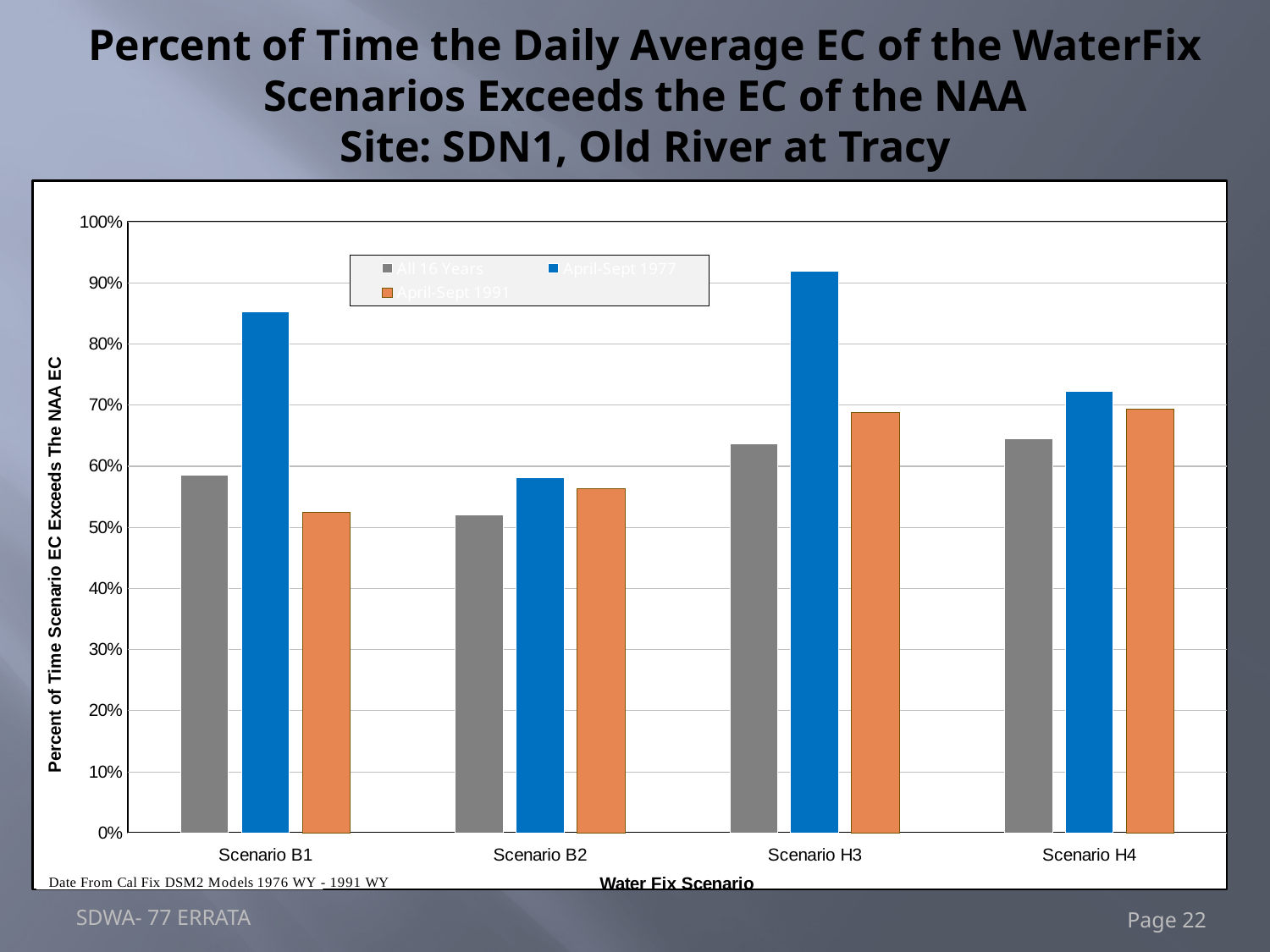
For Scenario H3, which is larger: the All 16 Years value or the April-Sept 1991 value? April-Sept 1991 What kind of chart is shown on the slide? bar chart Is the April-Sept 1991 value for Scenario H4 greater or less than 60%? greater How many scenarios are shown on the x axis? 4 For which scenario is the April-Sept 1977 value lowest? Scenario B2 For which scenario is the April-Sept 1977 value highest? Scenario H3 Is the All 16 Years value for Scenario B2 greater or less than 60%? less For Scenario B1, which is larger: the April-Sept 1977 value or the April-Sept 1991 value? April-Sept 1977 Is the April-Sept 1977 value for Scenario H3 greater or less than 90%? greater How many series does the legend list? 3 What is the title of the y axis? Percent of Time Scenario EC Exceeds The NAA EC